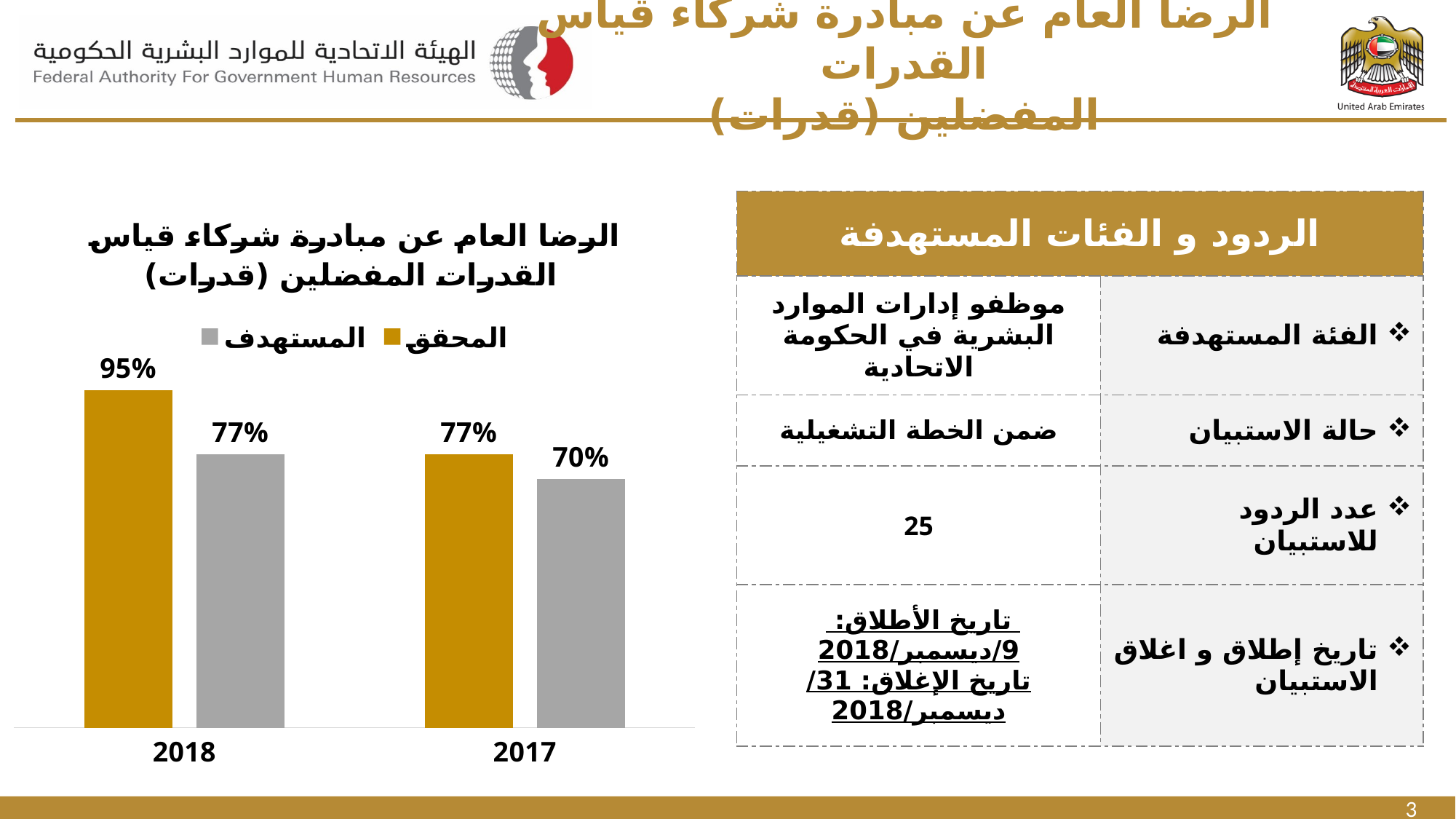
How many series does the chart legend list? 2 Which year has the lowest المستهدف (target) value? 2017 What is the value of المستهدف (target) for 2017? 70% How many years are shown on the x axis of the chart? 2 What is the difference between the المحقق (achieved) and المستهدف (target) values for 2018? 18% What type of chart is shown on the slide? Bar chart Which year has the highest المحقق (achieved) value? 2018 What is the difference between the المحقق (achieved) values for 2018 and 2017? 18% Which is larger for 2017: المحقق (achieved) or المستهدف (target)? المحقق (achieved) What is the value of المستهدف (target) for 2018? 77% What is the value of المحقق (achieved) for 2017? 77% What is the value of المحقق (achieved) for 2018? 95%